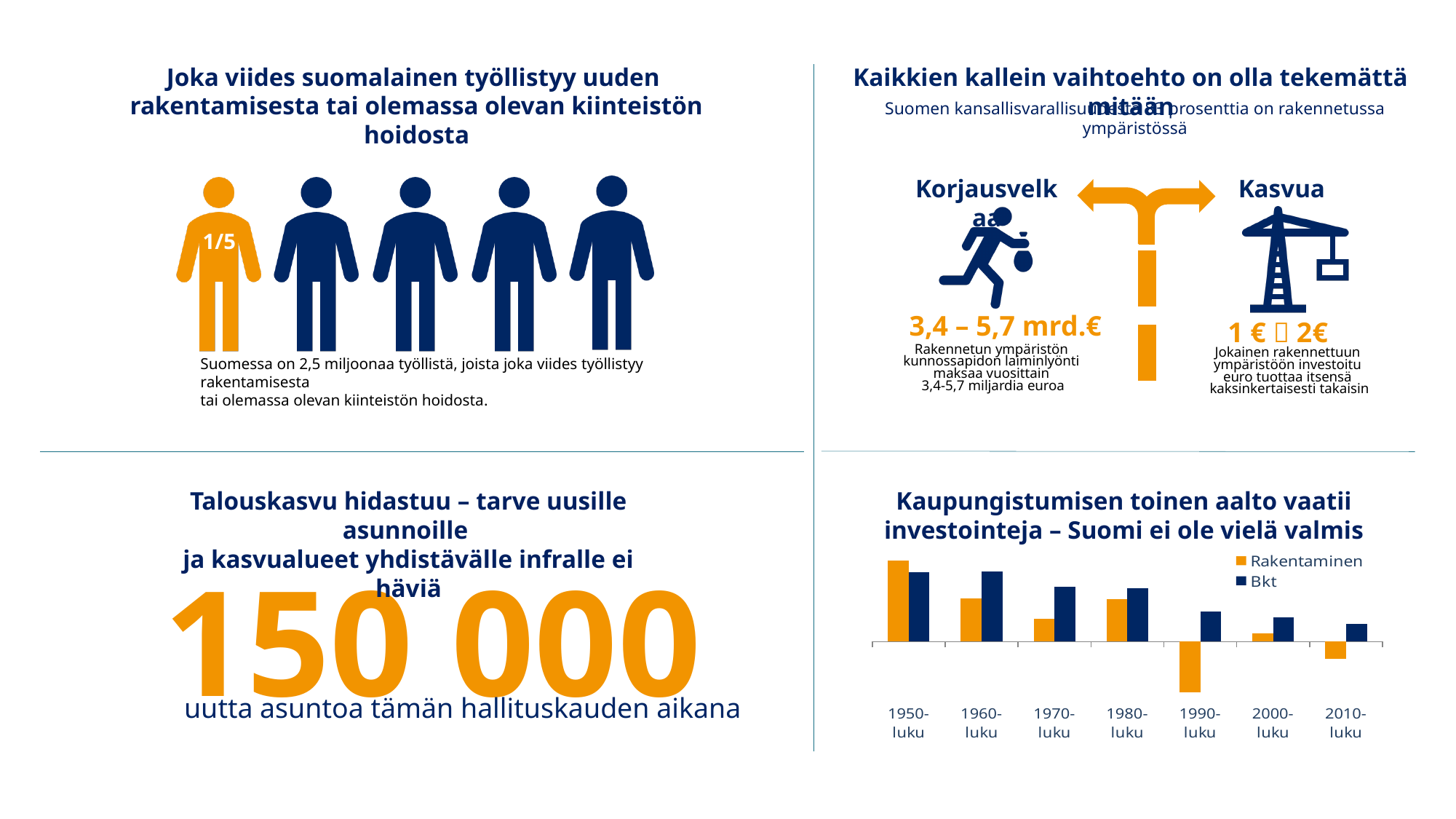
In the bottom-right bar chart, for 1990-luku, which is larger: Rakentaminen or Bkt? Bkt In the bottom-right bar chart, does the Bkt series generally rise or fall from 1950-luku to 2010-luku? fall In the bottom-right bar chart, which decade has the highest Rakentaminen value? 1950-luku How many series does the legend of the bottom-right bar chart list? 2 In the bottom-right bar chart, for 1960-luku, which is larger: Rakentaminen or Bkt? Bkt In the bottom-right bar chart, for 1950-luku, which is larger: Rakentaminen or Bkt? Rakentaminen In the bottom-right bar chart, in which decades is the Rakentaminen bar below zero? 1990-luku and 2010-luku How many decade categories are shown on the x axis of the bottom-right bar chart? 7 In the bottom-right bar chart, which decade has the lowest Rakentaminen value? 1990-luku In the bottom-right bar chart, which decade has the lowest Bkt value? 2010-luku What are the two series named in the legend of the bottom-right bar chart? Rakentaminen and Bkt What kind of chart is shown in the bottom-right panel of the slide? bar chart